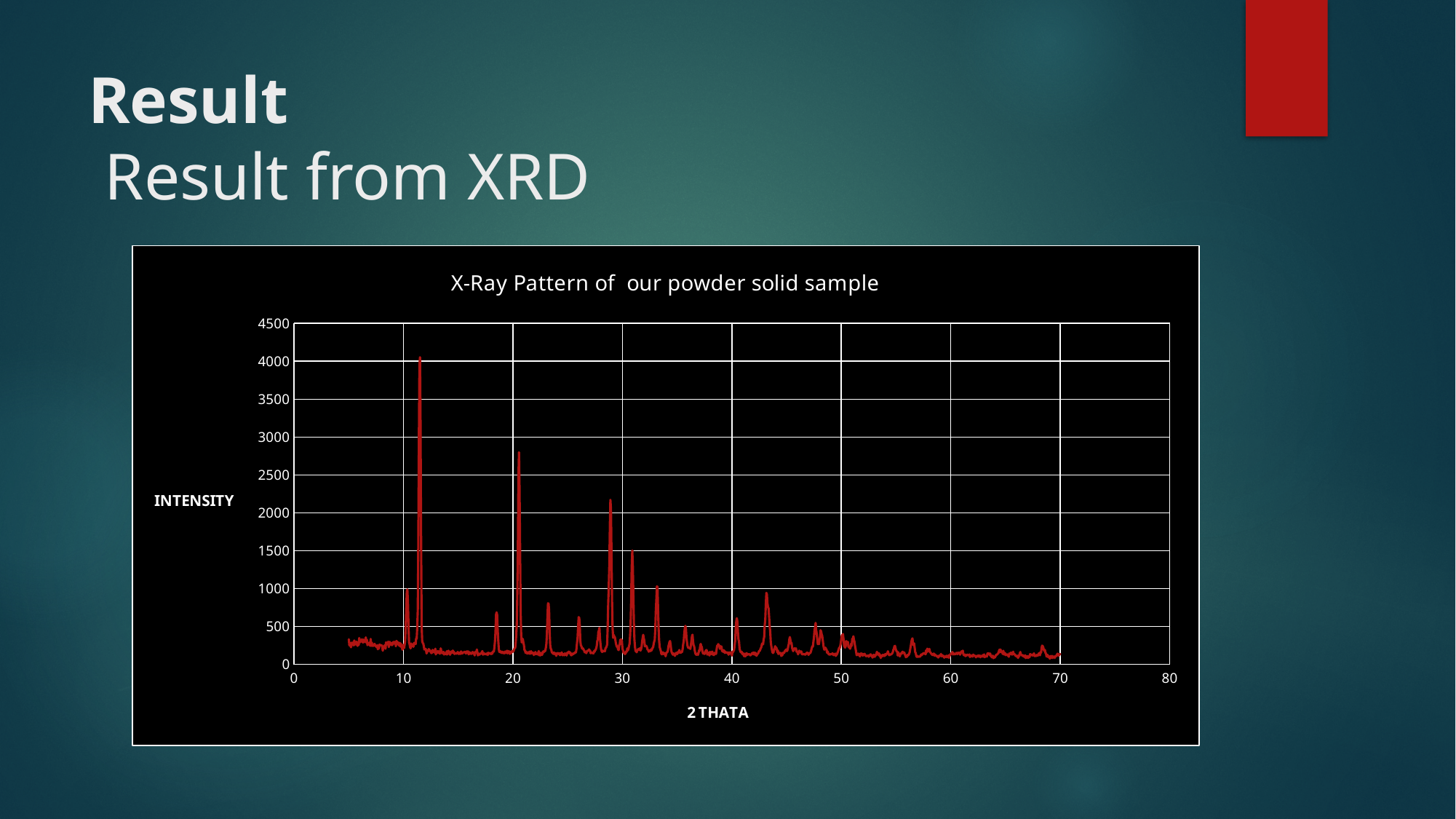
Is the intensity of the tallest peak greater or less than 3500? greater Is the intensity of the peak just before 2 THATA = 30 greater or less than 2000? greater Is the intensity of the peak just after 2 THATA = 20 greater or less than 2500? greater What kind of chart is shown on the slide? line chart Which x-axis tick is the tallest peak closest to? 10 Which peak is taller: the one just after 2 THATA = 20 or the one just before 2 THATA = 30? the one just after 20 What is the highest value shown on the vertical axis? 4500 What is the label on the vertical axis of the chart? INTENSITY What is the title of the chart? X-Ray Pattern of our powder solid sample Do the peak heights generally rise or fall as 2 THATA increases? fall